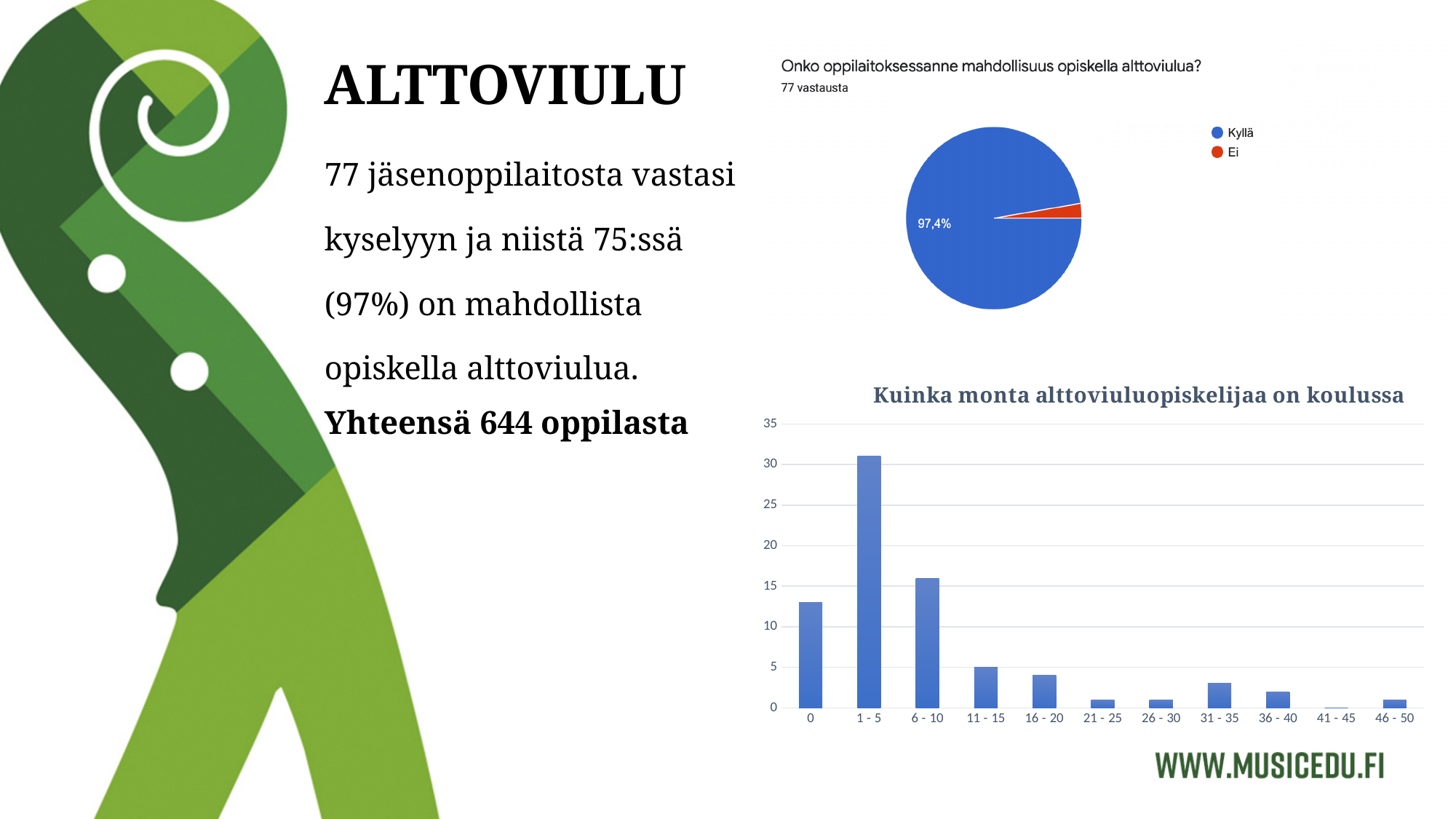
In the pie chart "Onko oppilaitoksessanne mahdollisuus opiskella alttoviulua?", what percentage is shown for Kyllä? 97,4% How many categories are shown on the x axis of the bar chart "Kuinka monta alttoviuluopiskelijaa on koulussa"? 11 What kind of chart is the chart titled "Kuinka monta alttoviuluopiskelijaa on koulussa"? bar chart How many entries does the legend of the pie chart "Onko oppilaitoksessanne mahdollisuus opiskella alttoviulua?" list? 2 What kind of chart is the chart titled "Onko oppilaitoksessanne mahdollisuus opiskella alttoviulua?"? pie chart In the bar chart "Kuinka monta alttoviuluopiskelijaa on koulussa", which is larger, the value for 6 - 10 or the value for 11 - 15? 6 - 10 In the bar chart "Kuinka monta alttoviuluopiskelijaa on koulussa", is the value for 1 - 5 greater or less than 30? greater In the pie chart "Onko oppilaitoksessanne mahdollisuus opiskella alttoviulua?", which category has the largest slice? Kyllä In the bar chart "Kuinka monta alttoviuluopiskelijaa on koulussa", is the value for 0 greater or less than 10? greater In the bar chart "Kuinka monta alttoviuluopiskelijaa on koulussa", which category has the highest bar? 1 - 5 In the bar chart "Kuinka monta alttoviuluopiskelijaa on koulussa", is the value for 6 - 10 greater or less than 20? less How many responses does the pie chart "Onko oppilaitoksessanne mahdollisuus opiskella alttoviulua?" state it is based on? 77 vastausta